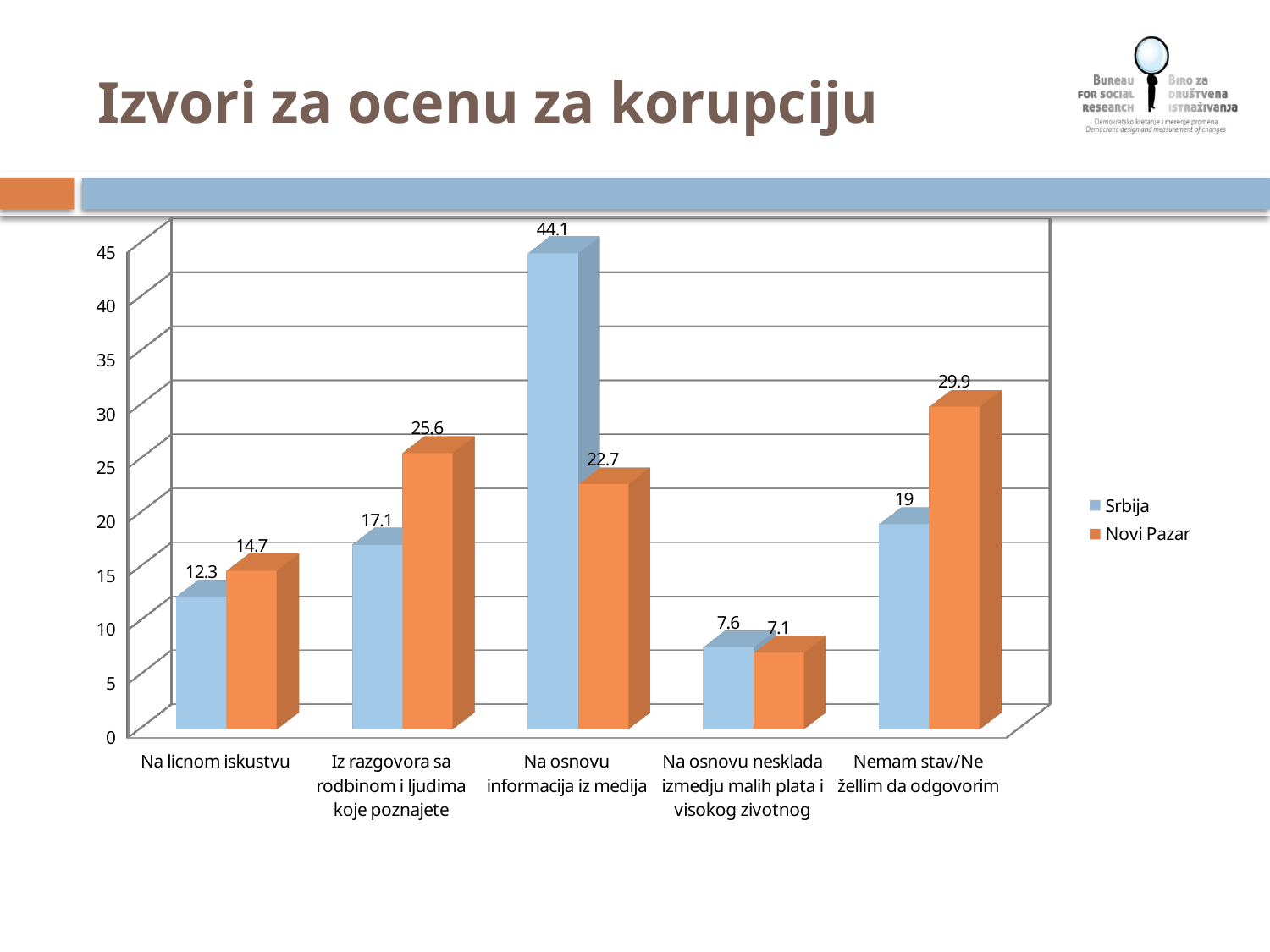
Which category has the lowest value for Novi Pazar? Na osnovu nesklada izmedju malih plata i visokog zivotnog What is the title of the slide? Izvori za ocenu za korupciju How many categories are shown on the x axis? 5 Which category has the highest value for Srbija? Na osnovu informacija iz medija What is the value for Novi Pazar in the 'Na licnom iskustvu' category? 14.7 Is the value for Srbija in the 'Nemam stav/Ne žellim da odgovorim' category greater or less than 20? less What kind of chart is shown on the slide? bar chart In the 'Iz razgovora sa rodbinom i ljudima koje poznajete' category, which series has the larger value, Srbija or Novi Pazar? Novi Pazar How many series does the legend list? 2 What is the value for Novi Pazar in the 'Nemam stav/Ne žellim da odgovorim' category? 29.9 What is the value for Srbija in the 'Na osnovu informacija iz medija' category? 44.1 What is the difference between the Srbija and Novi Pazar values in the 'Na osnovu informacija iz medija' category? 21.4